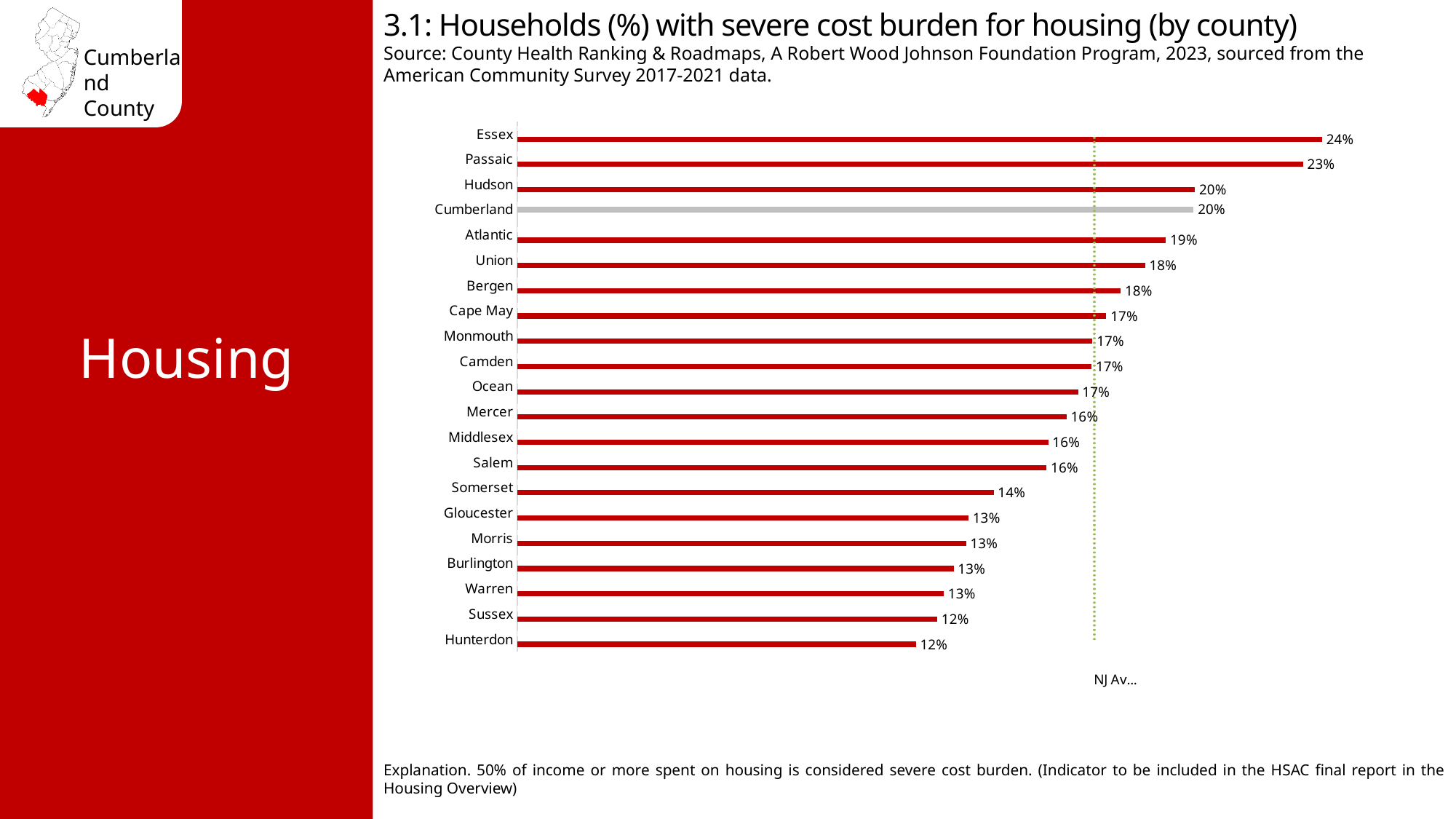
What is the difference in percentage points between Passaic and Cumberland? 3 percentage points What type of chart is used on this slide? Bar chart What is the value shown for Essex County? 24% What is the difference in percentage points between Essex and Hunterdon? 12 percentage points What is the value shown for Somerset County? 14% Which county has a higher value, Gloucester or Passaic? Passaic Which county has a higher value, Atlantic or Somerset? Atlantic What percentage of households in Cumberland County have a severe cost burden for housing? 20% Which county has the highest percentage of households with severe housing cost burden? Essex How many counties are shown in the chart? 21 Which county's bar is shown in grey instead of red? Cumberland What is the value shown for Hunterdon County? 12%